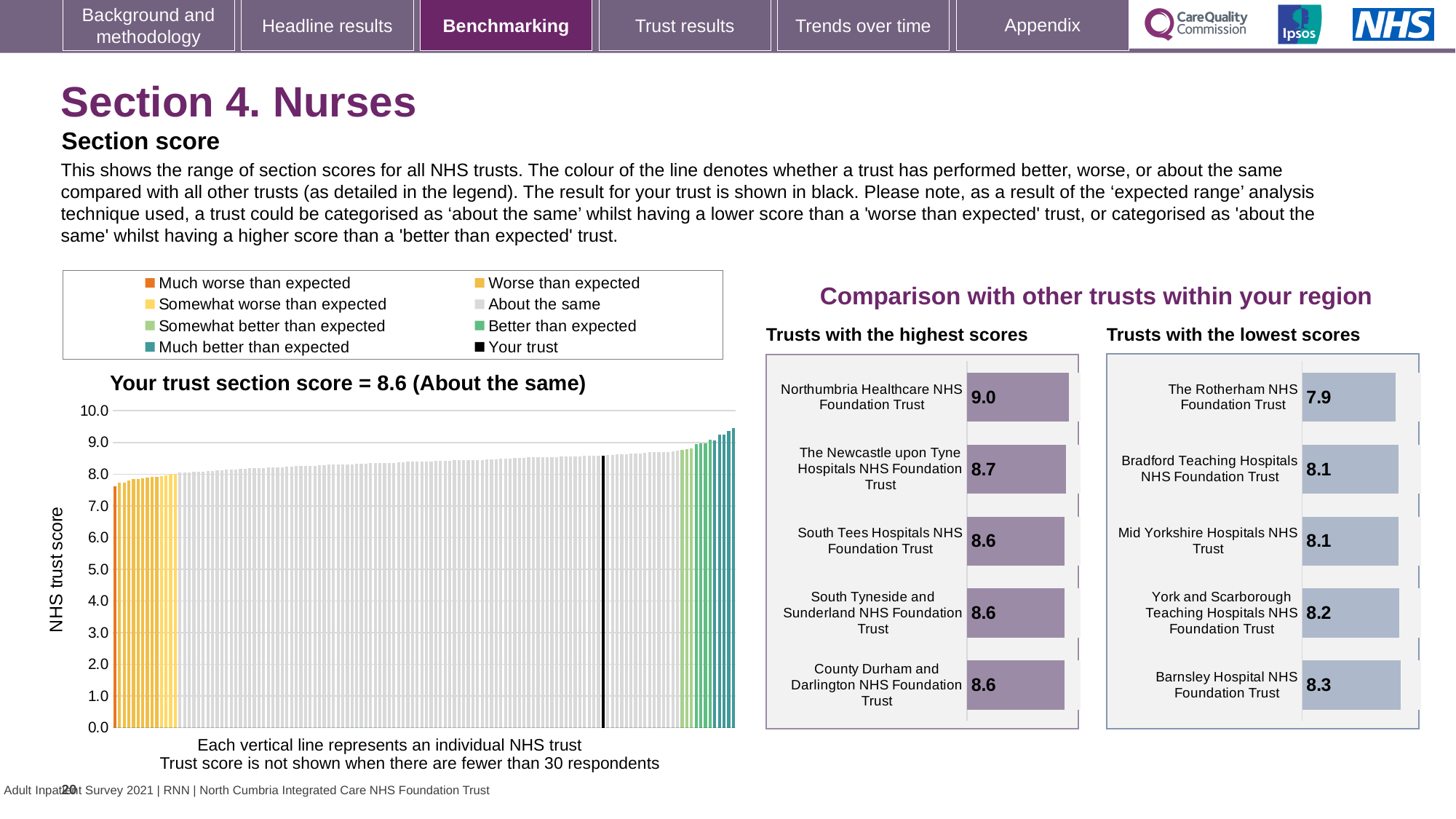
In the main chart on the left, do the trust scores rise or fall from left to right along the x axis? rise In the 'Trusts with the lowest scores' chart, how many trusts are shown? 5 In the 'Trusts with the highest scores' chart, what is the difference between the scores of Northumbria Healthcare NHS Foundation Trust and The Newcastle upon Tyne Hospitals NHS Foundation Trust? 0.3 In the 'Trusts with the lowest scores' chart, what is the difference between the scores of Barnsley Hospital NHS Foundation Trust and The Rotherham NHS Foundation Trust? 0.4 In the 'Trusts with the highest scores' chart, what is the score for The Newcastle upon Tyne Hospitals NHS Foundation Trust? 8.7 In the 'Trusts with the lowest scores' chart, what is the score for The Rotherham NHS Foundation Trust? 7.9 How many entries does the legend above the main chart on the left list? 8 In the 'Trusts with the lowest scores' chart, which trust has the lowest score? The Rotherham NHS Foundation Trust In the 'Trusts with the highest scores' chart, what is the score for Northumbria Healthcare NHS Foundation Trust? 9.0 In the 'Trusts with the lowest scores' chart, what is the score for Barnsley Hospital NHS Foundation Trust? 8.3 In the 'Trusts with the highest scores' chart, which trust has the highest score? Northumbria Healthcare NHS Foundation Trust In the main chart on the left, what is the section score for your trust, as stated in the chart title? 8.6